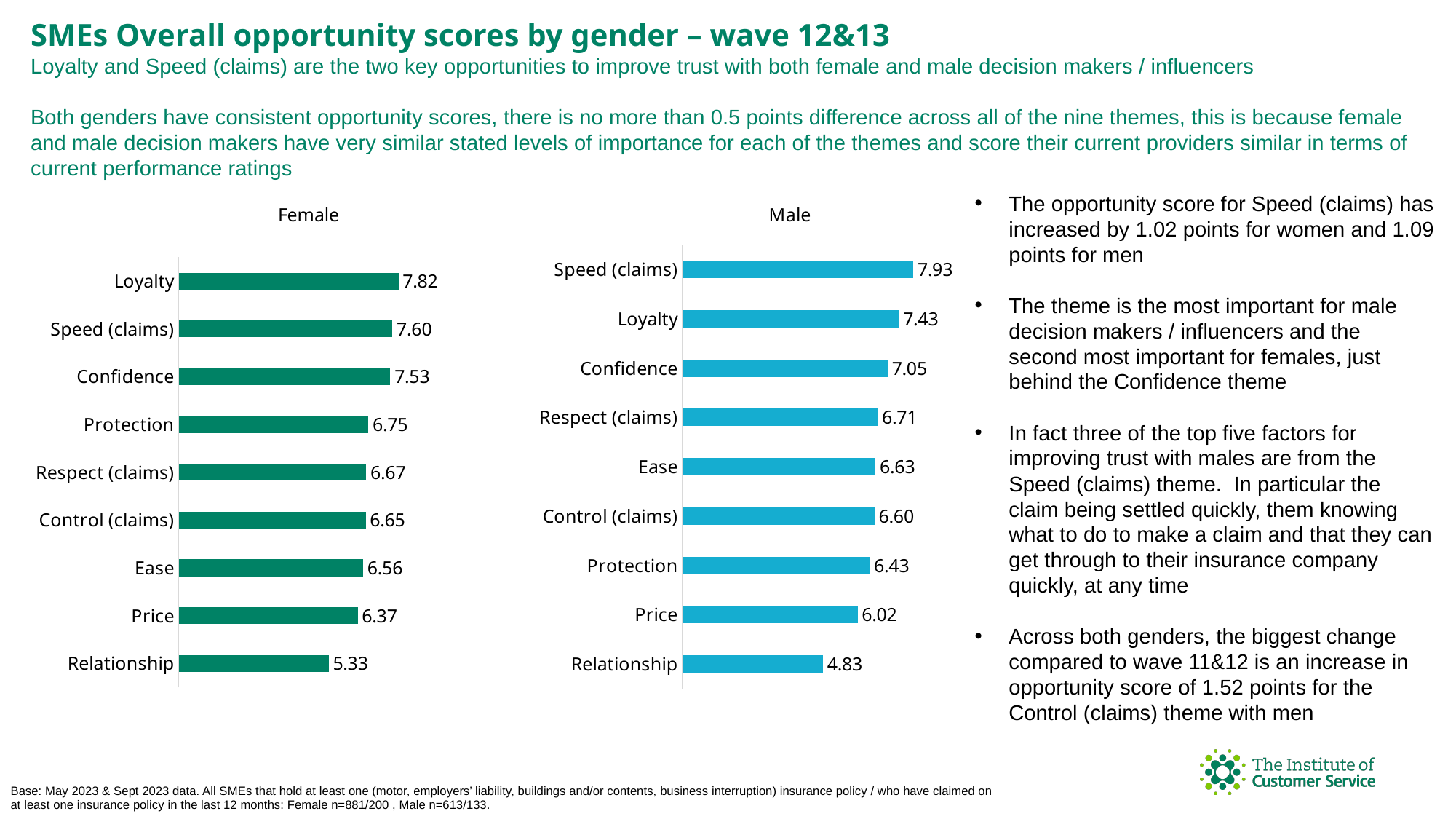
Which is larger: the Protection score in the Female chart or the Protection score in the Male chart? Female (6.75) In the Male chart, which theme has the highest opportunity score? Speed (claims) In the Male chart, what is the difference between the scores for Speed (claims) and Relationship? 3.10 In the Male chart, what is the opportunity score for Speed (claims)? 7.93 In the Female chart, what is the opportunity score for Ease? 6.56 What colour are the bars in the Female chart? Dark green What type of chart is the Male chart? Bar chart In the Female chart, what is the opportunity score for Loyalty? 7.82 In the Male chart, what is the opportunity score for Control (claims)? 6.60 In the Female chart, which theme has the lowest opportunity score? Relationship How many themes are plotted in the Female chart? 9 In the Female chart, what is the difference between the scores for Loyalty and Price? 1.45